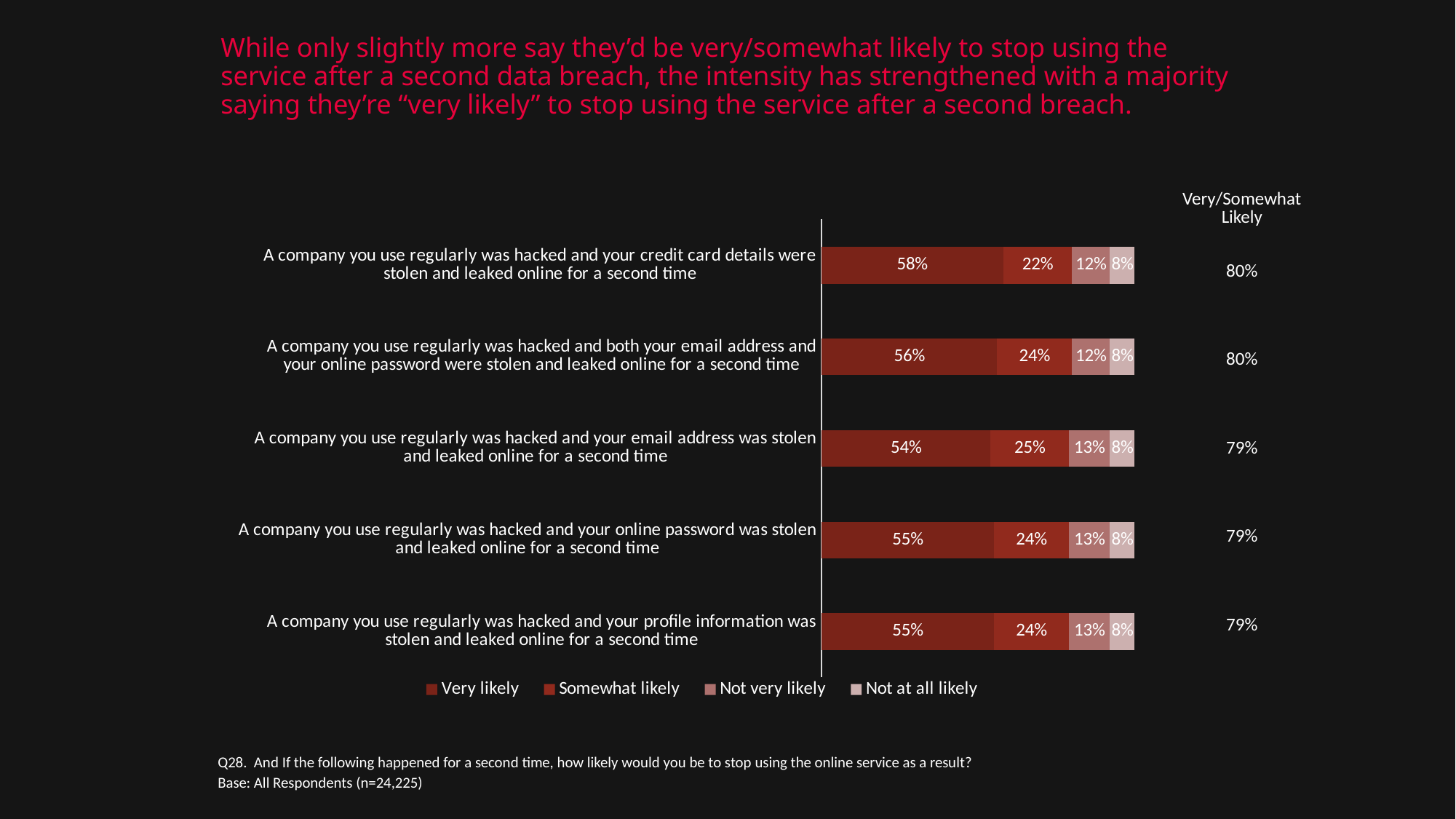
What is the 'Very likely' value for the scenario where credit card details were stolen and leaked online for a second time? 58% What is the total of the stacked bar for the scenario where profile information was stolen and leaked online for a second time? 100% What is the 'Not very likely' value for the scenario where the online password was stolen and leaked online for a second time? 13% Which is larger: the 'Somewhat likely' value for the credit card details scenario or for the email address scenario? the email address scenario How many series does the legend list? 4 How many scenarios (categories) are plotted in the chart? 5 Which scenario has the highest 'Very likely' value? A company you use regularly was hacked and your credit card details were stolen and leaked online for a second time What is the difference in 'Very likely' values between the credit card details scenario and the email address scenario? 4 percentage points What is the 'Somewhat likely' value for the scenario where the email address was stolen and leaked online for a second time? 25% Which scenario has the lowest 'Very likely' value? A company you use regularly was hacked and your email address was stolen and leaked online for a second time What kind of chart is shown on the slide? bar chart What is the Very/Somewhat Likely figure shown for the scenario where both the email address and online password were stolen and leaked online for a second time? 80%